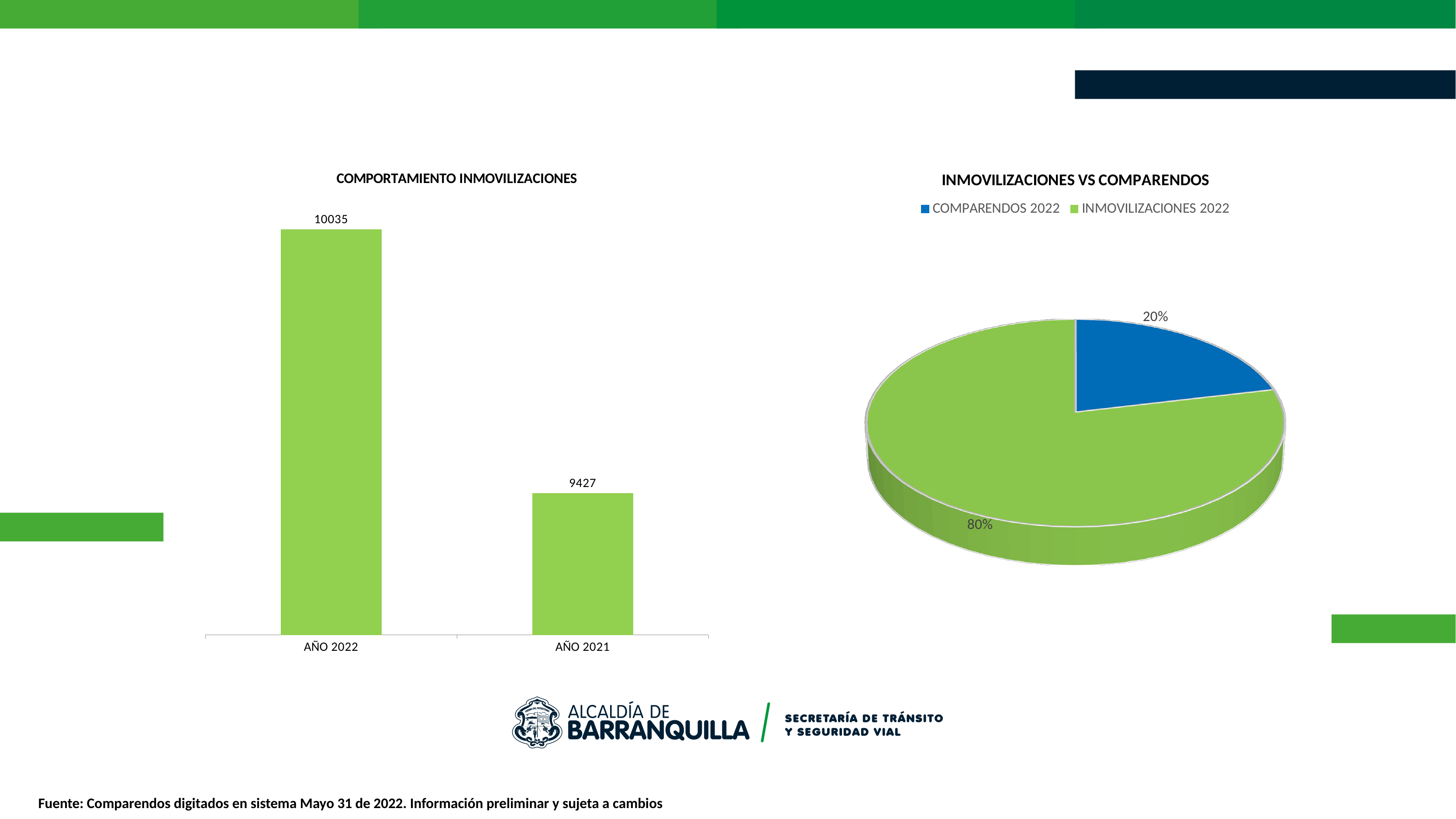
In the 'COMPORTAMIENTO INMOVILIZACIONES' chart, what is the difference between the values for AÑO 2022 and AÑO 2021? 608 What kind of chart is 'INMOVILIZACIONES VS COMPARENDOS'? Pie chart In the 'COMPORTAMIENTO INMOVILIZACIONES' chart, what is the value for AÑO 2021? 9427 In the 'INMOVILIZACIONES VS COMPARENDOS' chart, how many entries does the legend list? 2 What kind of chart is 'COMPORTAMIENTO INMOVILIZACIONES'? Bar chart In the 'INMOVILIZACIONES VS COMPARENDOS' chart, what share does COMPARENDOS 2022 have? 20% In the 'COMPORTAMIENTO INMOVILIZACIONES' chart, how many categories are shown? 2 In the 'COMPORTAMIENTO INMOVILIZACIONES' chart, what is the value for AÑO 2022? 10035 In the 'COMPORTAMIENTO INMOVILIZACIONES' chart, which category has the highest value? AÑO 2022 In the 'INMOVILIZACIONES VS COMPARENDOS' chart, which slice is larger, COMPARENDOS 2022 or INMOVILIZACIONES 2022? INMOVILIZACIONES 2022 In the 'COMPORTAMIENTO INMOVILIZACIONES' chart, which category has the lowest value? AÑO 2021 In the 'INMOVILIZACIONES VS COMPARENDOS' chart, what share does INMOVILIZACIONES 2022 have? 80%